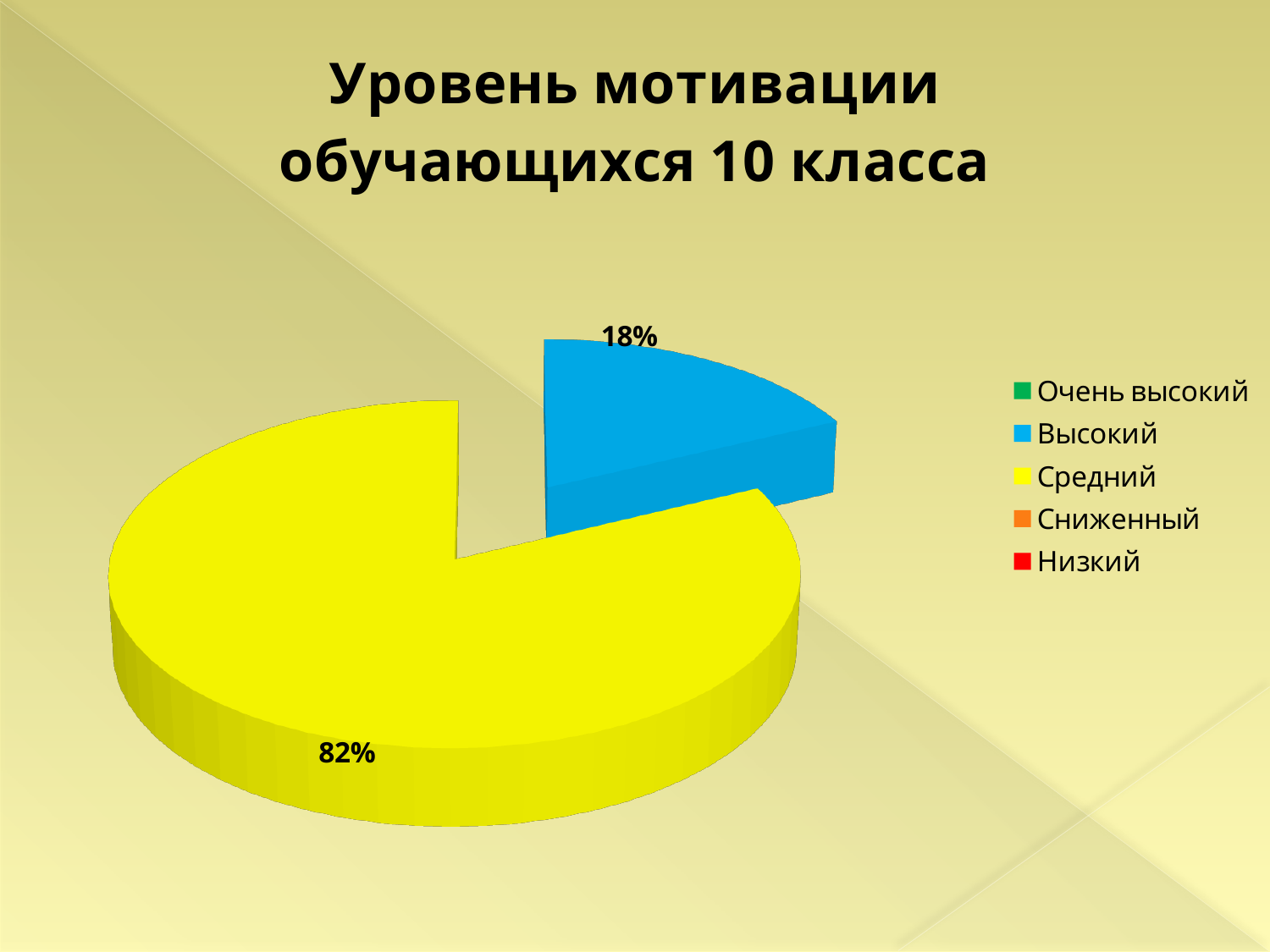
Which category has the largest slice of the pie? Средний What is the title of the chart? Уровень мотивации обучающихся 10 класса Which is larger, the Высокий slice or the Средний slice? Средний How many slices with data labels are visible in the pie? 2 What percentage is shown for the Высокий slice? 18% What is the difference between the Средний and Высокий slices? 64% What percentage is shown for the Средний slice? 82% What kind of chart is shown on the slide? pie chart What share of the pie does the Средний slice represent? 82% How many entries does the legend list? 5 What colour is the Высокий slice? blue Which of the two labelled slices is smaller, Высокий or Средний? Высокий